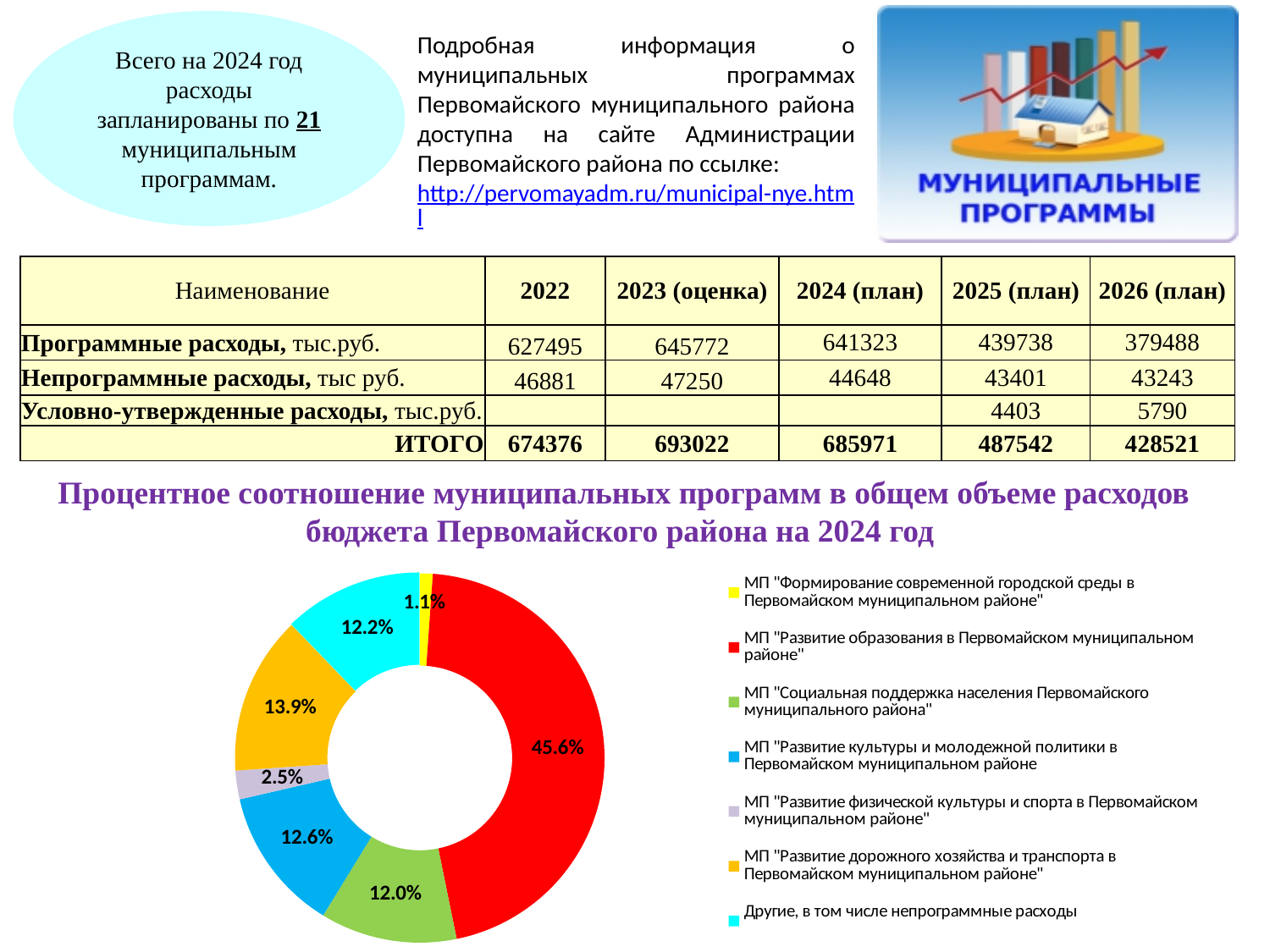
What share of the 2024 budget expenditure does the programme "Развитие образования в Первомайском муниципальном районе" have? 45.6% What share is shown for "Социальная поддержка населения Первомайского муниципального района"? 12.0% What share is shown for "Другие, в том числе непрограммные расходы"? 12.2% What is the difference between the share for "Развитие образования" (45.6%) and the share for "Развитие дорожного хозяйства и транспорта" (13.9%)? 31.7% Which is larger: the share for "Развитие культуры и молодежной политики" or the share for "Социальная поддержка населения"? Развитие культуры и молодежной политики (12.6%) What share is shown for "Развитие физической культуры и спорта в Первомайском муниципальном районе"? 2.5% What kind of chart is shown at the bottom of the slide? Doughnut (pie) chart Which programme has the smallest share in the doughnut chart? МП "Формирование современной городской среды в Первомайском муниципальном районе" What colour is the slice representing "Развитие образования в Первомайском муниципальном районе"? Red How many slices does the doughnut chart have? 7 Which programme has the largest share in the doughnut chart? МП "Развитие образования в Первомайском муниципальном районе" What share is shown for "Развитие дорожного хозяйства и транспорта в Первомайском муниципальном районе"? 13.9%